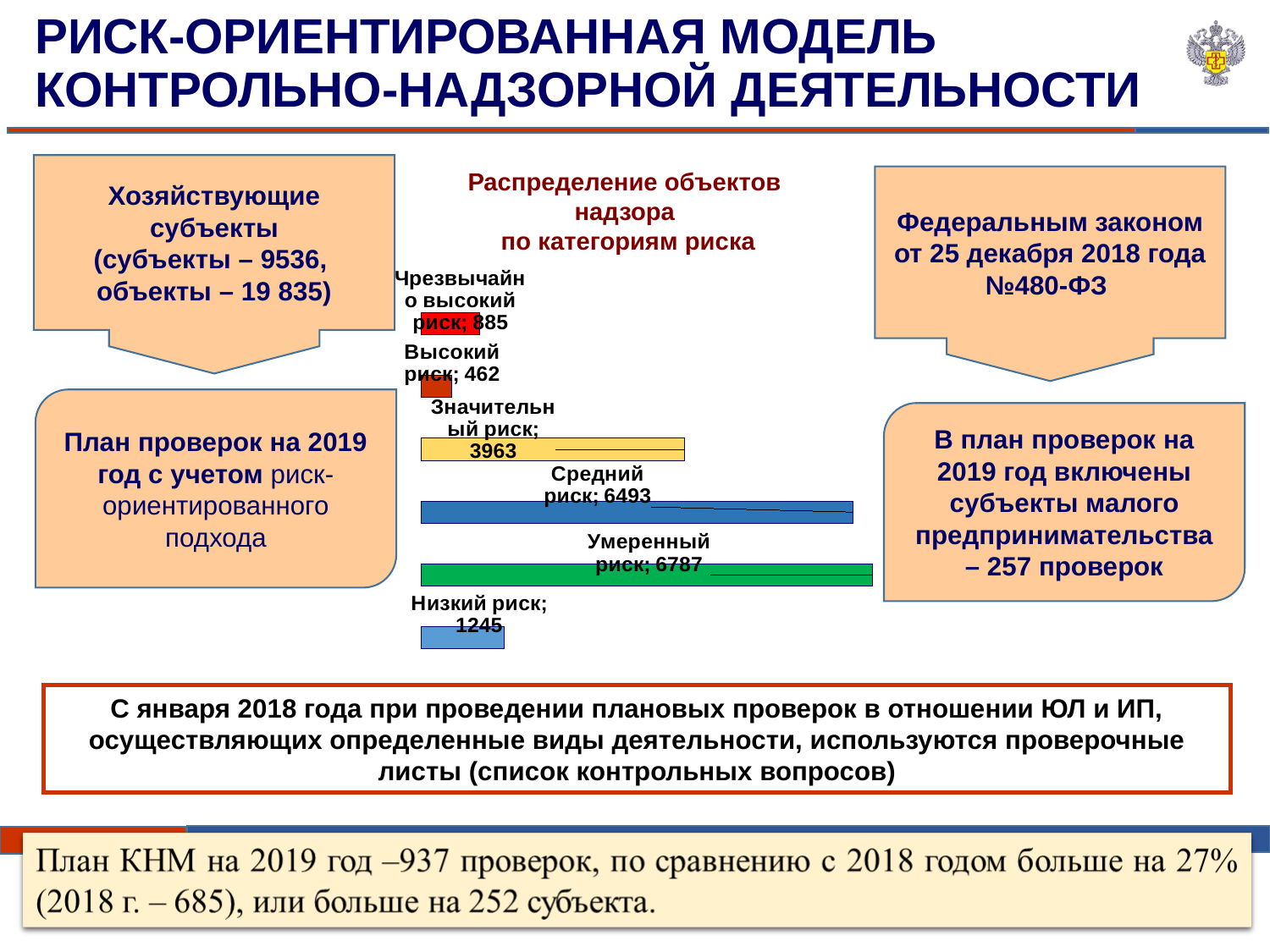
What kind of chart is shown on the slide? bar chart How many risk categories are plotted in the chart? 6 What is the title of the chart? Распределение объектов надзора по категориям риска Which is larger, the value for Значительный риск or the value for Низкий риск? Значительный риск What is the value for Высокий риск? 462 What is the value for Средний риск? 6493 Which risk category has the lowest value? Высокий риск What is the value for Значительный риск? 3963 What is the value for Низкий риск? 1245 What is the difference between the values for Умеренный риск and Средний риск? 294 Which risk category has the highest value? Умеренный риск What is the value for Умеренный риск? 6787